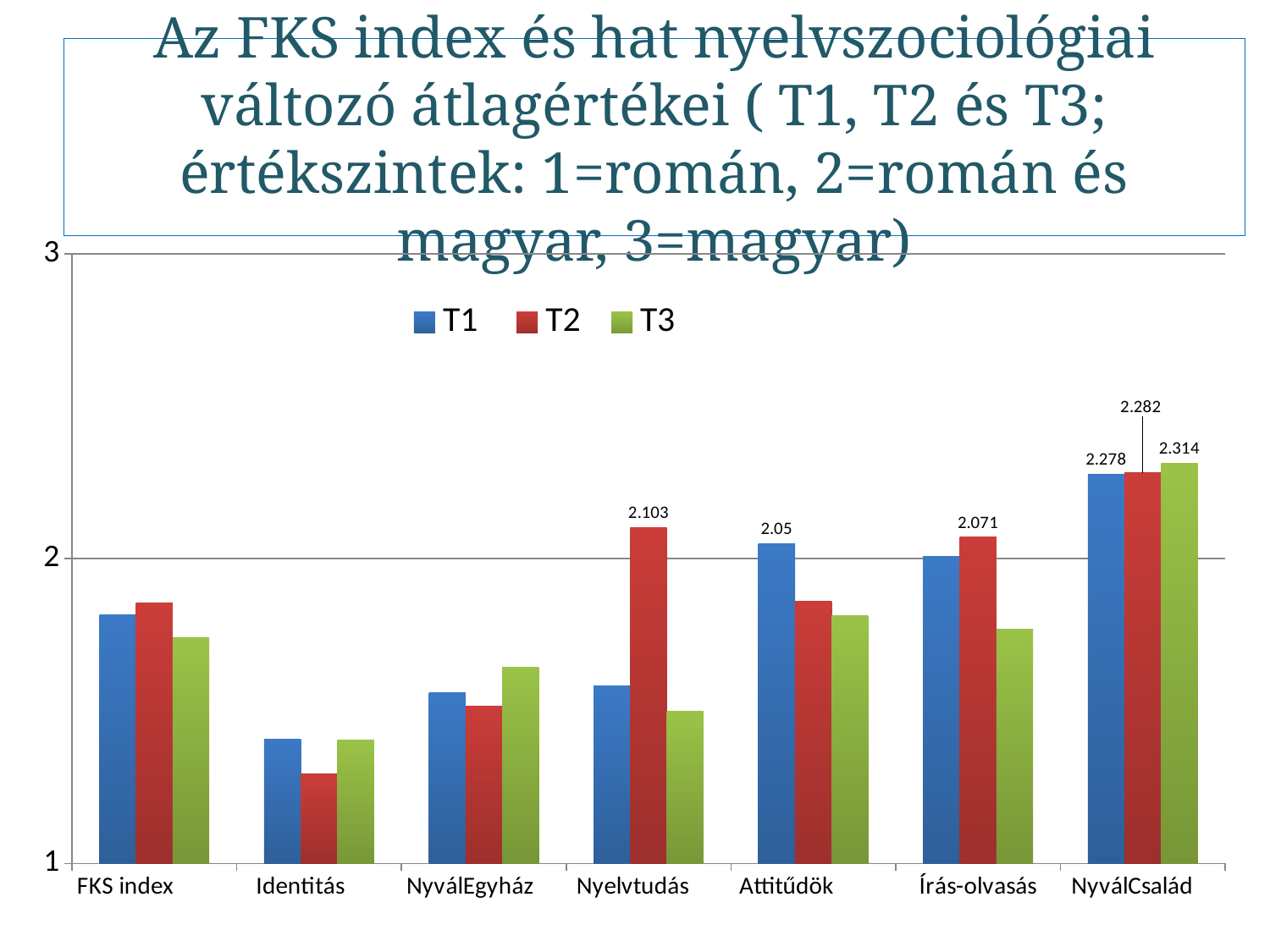
Which is larger: the T2 value for Nyelvtudás or the T1 value for Attitűdök? T2 value for Nyelvtudás Which category has the lowest T2 value? Identitás What kind of chart is shown on the slide? bar chart What is the T2 value for Nyelvtudás? 2.103 What is the difference between the T3 and T1 values for NyválCsalád? 0.036 What is the T1 value for Attitűdök? 2.05 What is the T2 value for Írás-olvasás? 2.071 What is the T3 value for NyválCsalád? 2.314 How many categories are shown on the x axis? 7 Is the T1 value for Identitás greater or less than 2? less How many series does the legend list? 3 Which category has the highest T3 value? NyválCsalád